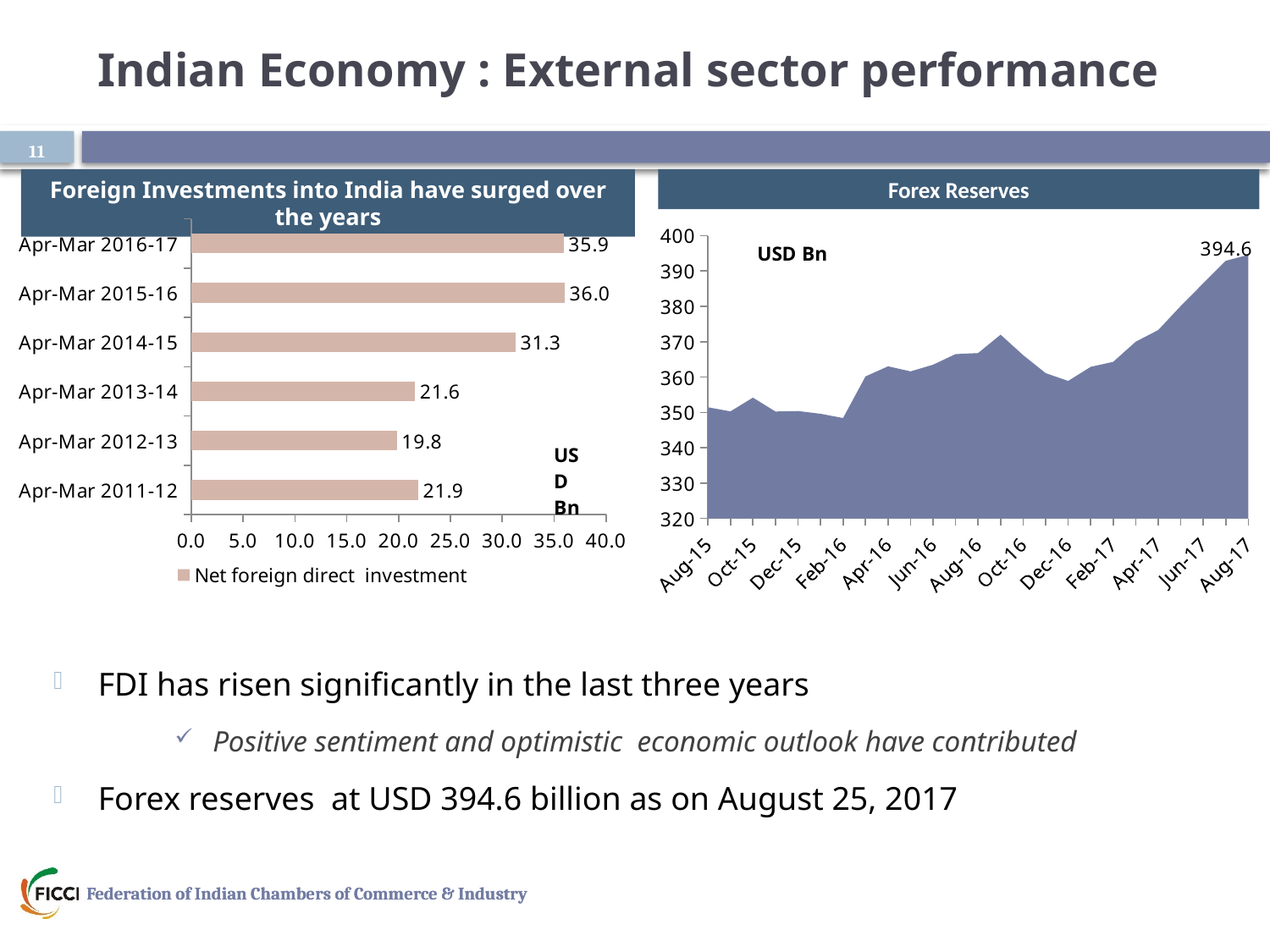
On the 'Foreign Investments into India have surged over the years' chart, what is the value for Apr-Mar 2014-15? 31.3 On the 'Forex Reserves' chart, is the value for Feb-16 greater or less than 360? less On the 'Forex Reserves' chart, is the value for Oct-16 greater or less than 360? greater On the 'Foreign Investments into India have surged over the years' chart, which period has the lowest net foreign direct investment? Apr-Mar 2012-13 On the 'Forex Reserves' chart, what is the value shown for Aug-17? 394.6 On the 'Foreign Investments into India have surged over the years' chart, which period has the highest net foreign direct investment? Apr-Mar 2015-16 On the 'Foreign Investments into India have surged over the years' chart, what is the difference between the values for Apr-Mar 2014-15 and Apr-Mar 2013-14? 9.7 On the 'Foreign Investments into India have surged over the years' chart, which is larger: the value for Apr-Mar 2011-12 or Apr-Mar 2012-13? Apr-Mar 2011-12 What type of chart is the 'Foreign Investments into India have surged over the years' chart? Bar chart How many periods are shown on the 'Foreign Investments into India have surged over the years' chart? 6 On the 'Forex Reserves' chart, do the values generally rise or fall from Dec-16 to Aug-17? Rise On the 'Foreign Investments into India have surged over the years' chart, what is the net foreign direct investment for Apr-Mar 2016-17? 35.9